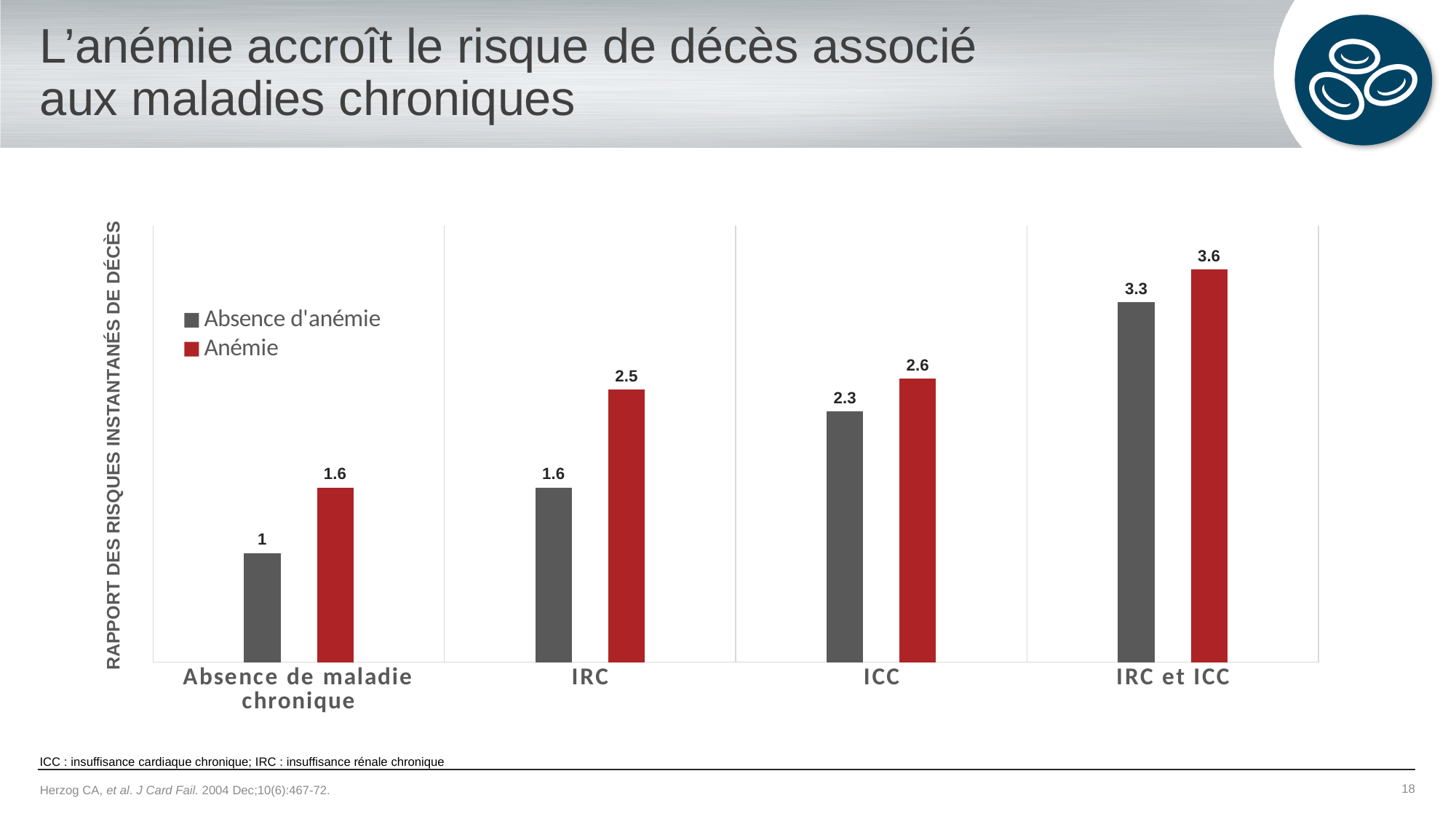
What is the value for Anémie in the IRC category? 2.5 What is the value for Anémie in the IRC et ICC category? 3.6 What is the difference between the Anémie and Absence d'anémie values in the IRC category? 0.9 How many categories are shown on the x axis? 4 What kind of chart is shown on the slide? Bar chart Which is larger in the ICC category: the Anémie value or the Absence d'anémie value? Anémie Which category has the lowest value for the Absence d'anémie series? Absence de maladie chronique How many series does the legend list? 2 What is the label of the y axis? RAPPORT DES RISQUES INSTANTANÉS DE DÉCÈS Which category has the highest value for the Anémie series? IRC et ICC What is the value for Absence d'anémie in the ICC category? 2.3 What is the value for Absence d'anémie in the Absence de maladie chronique category? 1